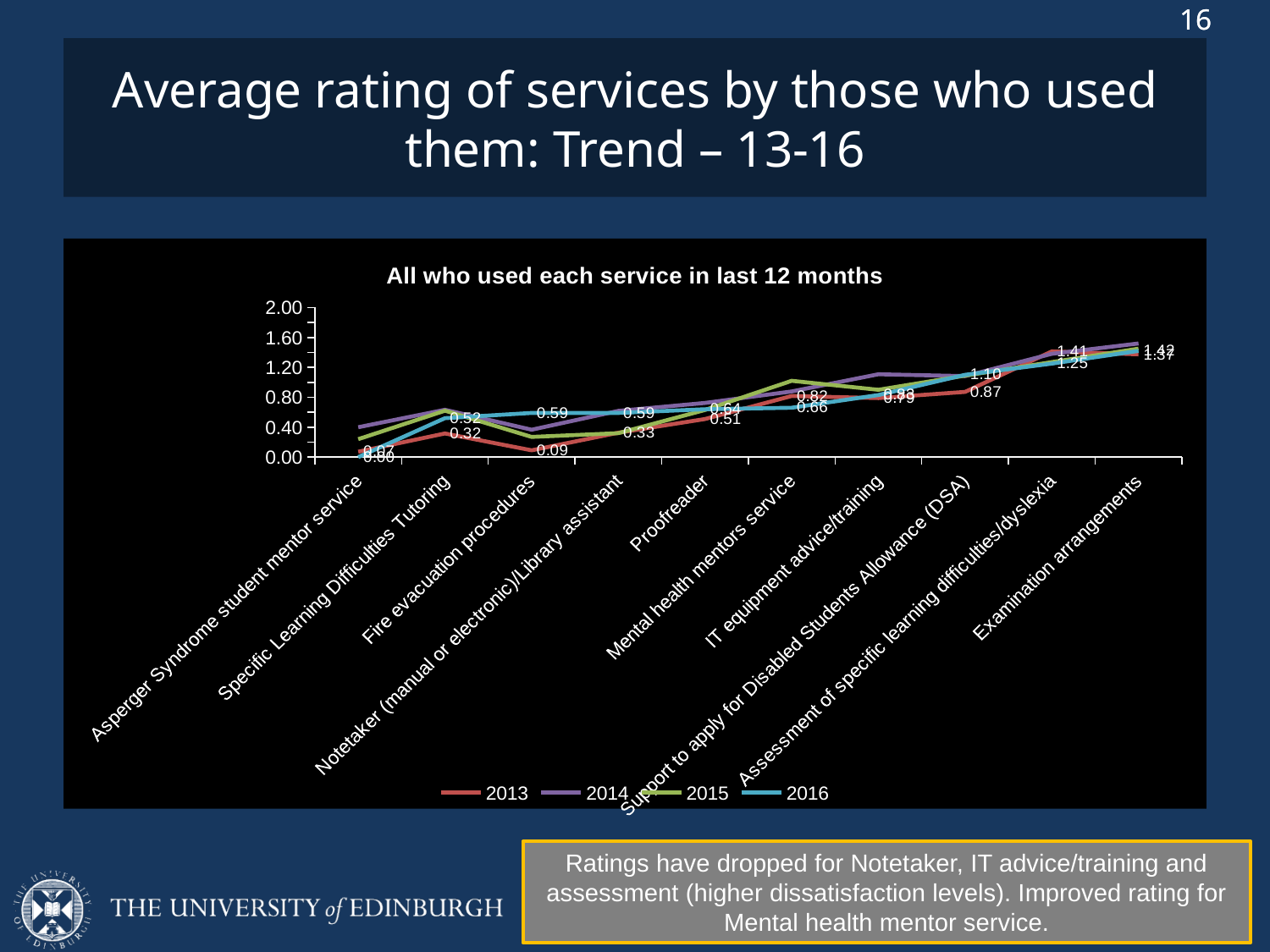
What is the 2016 value for Support to apply for Disabled Students Allowance (DSA)? 1.10 Is the value for Examination arrangements in 2016 greater or less than 1.20? greater Do the plotted values generally rise or fall moving from left to right along the x axis? Rise Is the value for Asperger Syndrome student mentor service in 2014 greater or less than 0.80? less Which years are listed in the chart legend? 2013, 2014, 2015, 2016 What is the 2016 value for Fire evacuation procedures? 0.59 How many series does the legend list? 4 What kind of chart is shown on the slide? Line chart How many service categories are plotted along the x axis? 10 What is the 2013 value for Support to apply for Disabled Students Allowance (DSA)? 0.87 What is the title printed above the chart? All who used each service in last 12 months What is the 2013 value for Fire evacuation procedures? 0.09